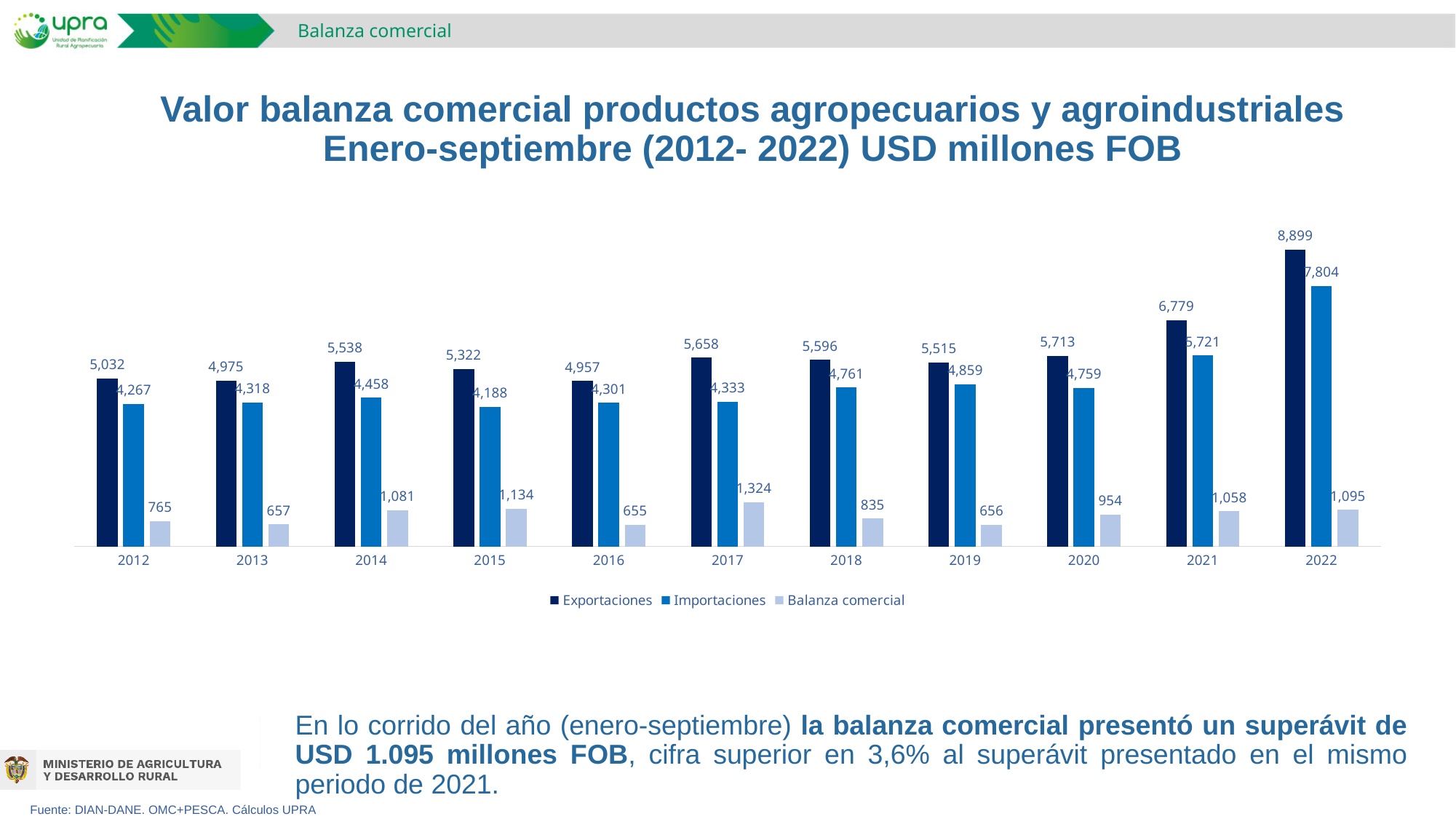
What is the Balanza comercial value for 2017? 1,324 What is the value of Importaciones in 2015? 4,188 Which is larger, Importaciones in 2019 or Importaciones in 2020? Importaciones in 2019 Does the Importaciones value rise or fall from 2020 to 2022? Rise Which series is shown in the darkest blue colour? Exportaciones Which year has the highest Exportaciones value? 2022 What is the value of Exportaciones in 2022? 8,899 How many series does the legend list? 3 How many years are shown on the x axis? 11 What is the difference between Exportaciones and Importaciones in 2021? 1,058 What kind of chart is shown on the slide? Bar chart Which year has the lowest Balanza comercial value? 2016